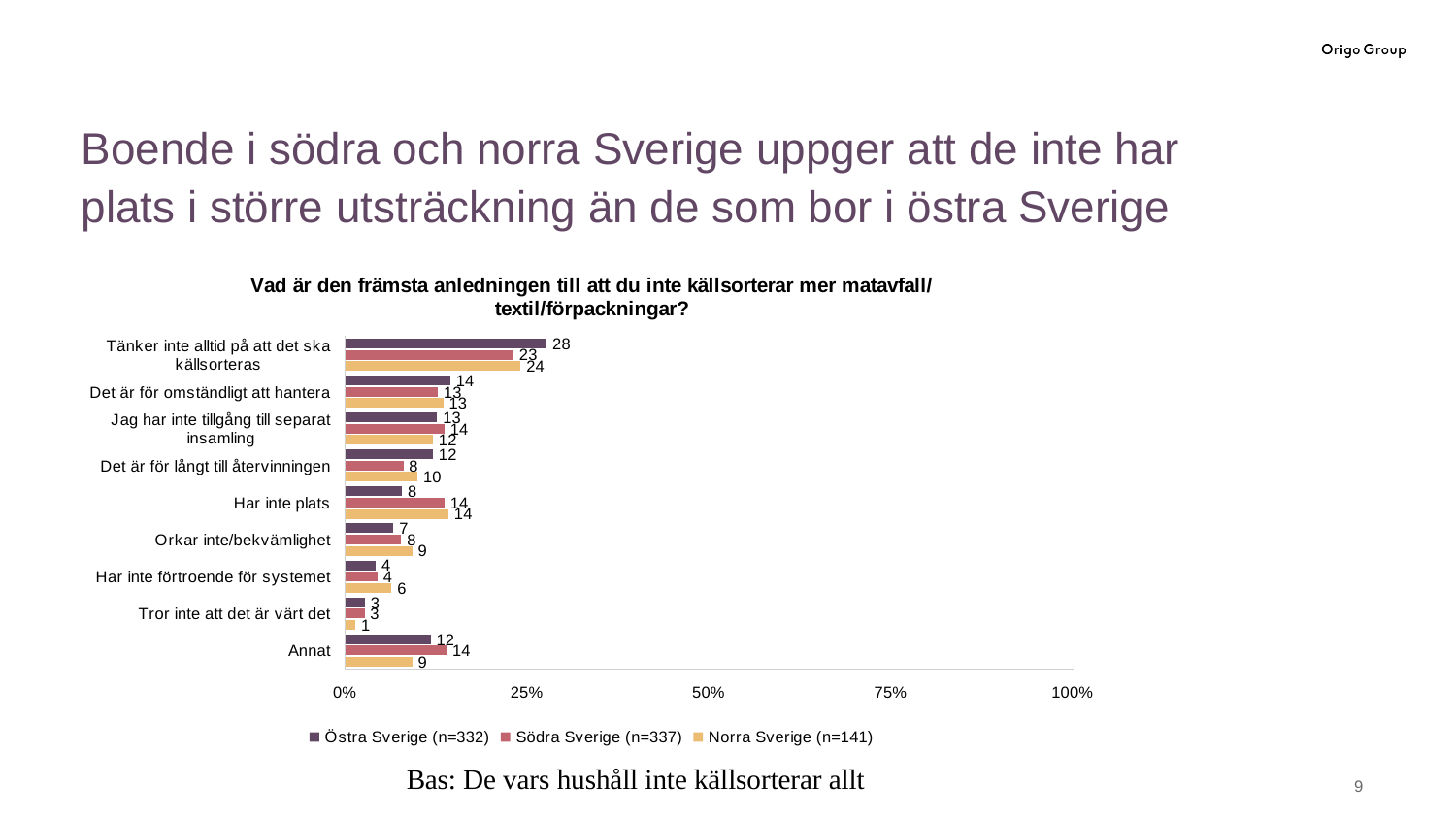
What is the value for Norra Sverige for "Har inte förtroende för systemet"? 6 Is the value for Östra Sverige for "Tänker inte alltid på att det ska källsorteras" greater or less than 25%? greater How many categories are shown on the chart? 9 How many series does the legend list? 3 Which category has the lowest value for Norra Sverige? Tror inte att det är värt det What is the value for Östra Sverige for "Tänker inte alltid på att det ska källsorteras"? 28 Which category has the highest value for Östra Sverige? Tänker inte alltid på att det ska källsorteras For "Det är för långt till återvinningen", which is larger: Östra Sverige or Södra Sverige? Östra Sverige What is the value for Södra Sverige for "Har inte plats"? 14 What kind of chart is shown on the slide? Bar chart What is the difference between Södra Sverige and Östra Sverige for "Har inte plats"? 6 What is the sample size (n) for Norra Sverige shown in the legend? 141